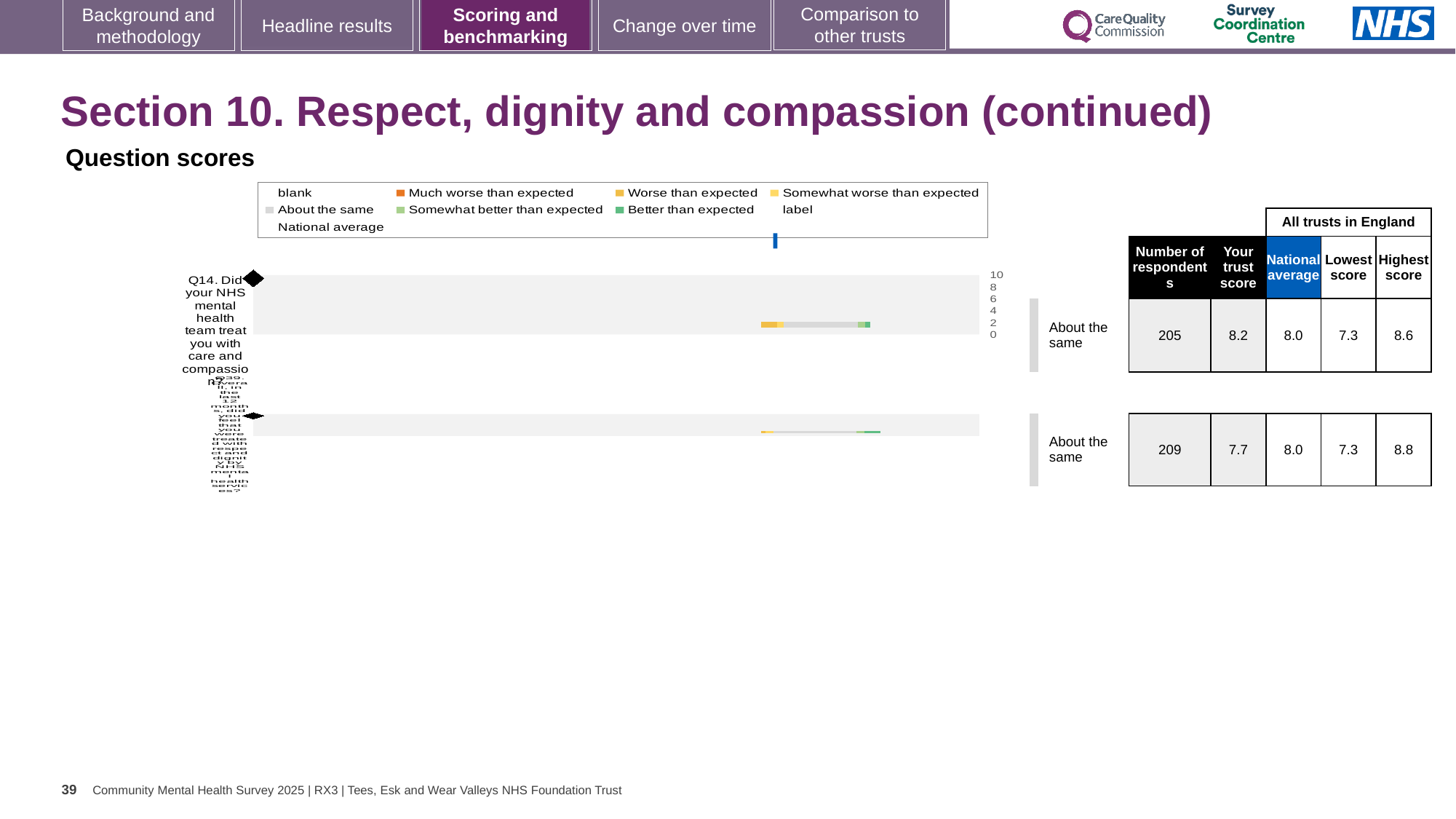
By how much does the trust score for Q14 exceed the national average? 0.2 What is the national average score for Q14? 8.0 What is the trust score for Q39? 7.7 What benchmark category is shown for Q14? About the same What is the highest score among all trusts in England for Q39? 8.8 How many questions are plotted in the chart? 2 What is the difference between the highest and lowest scores for Q39? 1.5 What is the trust score for Q14 (Did your NHS mental health team treat you with care and compassion?)? 8.2 Which question has the higher trust score, Q14 or Q39? Q14 How many respondents answered Q39? 209 How many respondents answered Q14? 205 For Q39, is the trust score higher or lower than the national average? lower